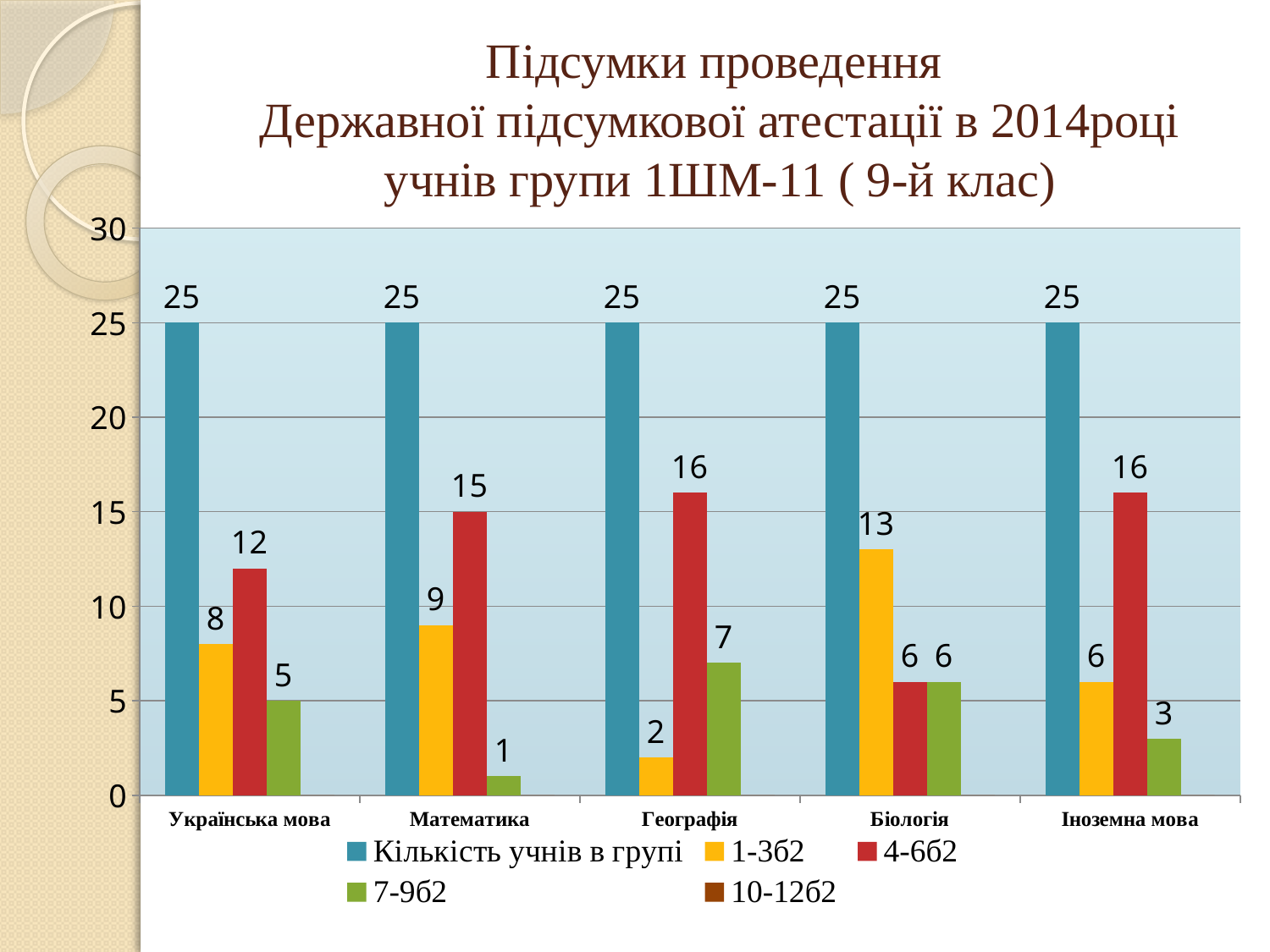
What is the value of the 4-6б2 series for Математика? 15 What kind of chart is shown on the slide? Bar chart Which is larger: the 1-3б2 value for Математика or the 1-3б2 value for Географія? Математика What colour are the bars for the 4-6б2 series? Red What is the value of the 1-3б2 series for Біологія? 13 What is the difference between the 4-6б2 value and the 1-3б2 value for Українська мова? 4 What is the value of the 7-9б2 series for Географія? 7 How many categories are shown on the x axis? 5 Which category has the highest value for the 1-3б2 series? Біологія How many series does the legend list? 5 Which category has the lowest value for the 7-9б2 series? Математика What is the value of the Кількість учнів в групі series for Іноземна мова? 25